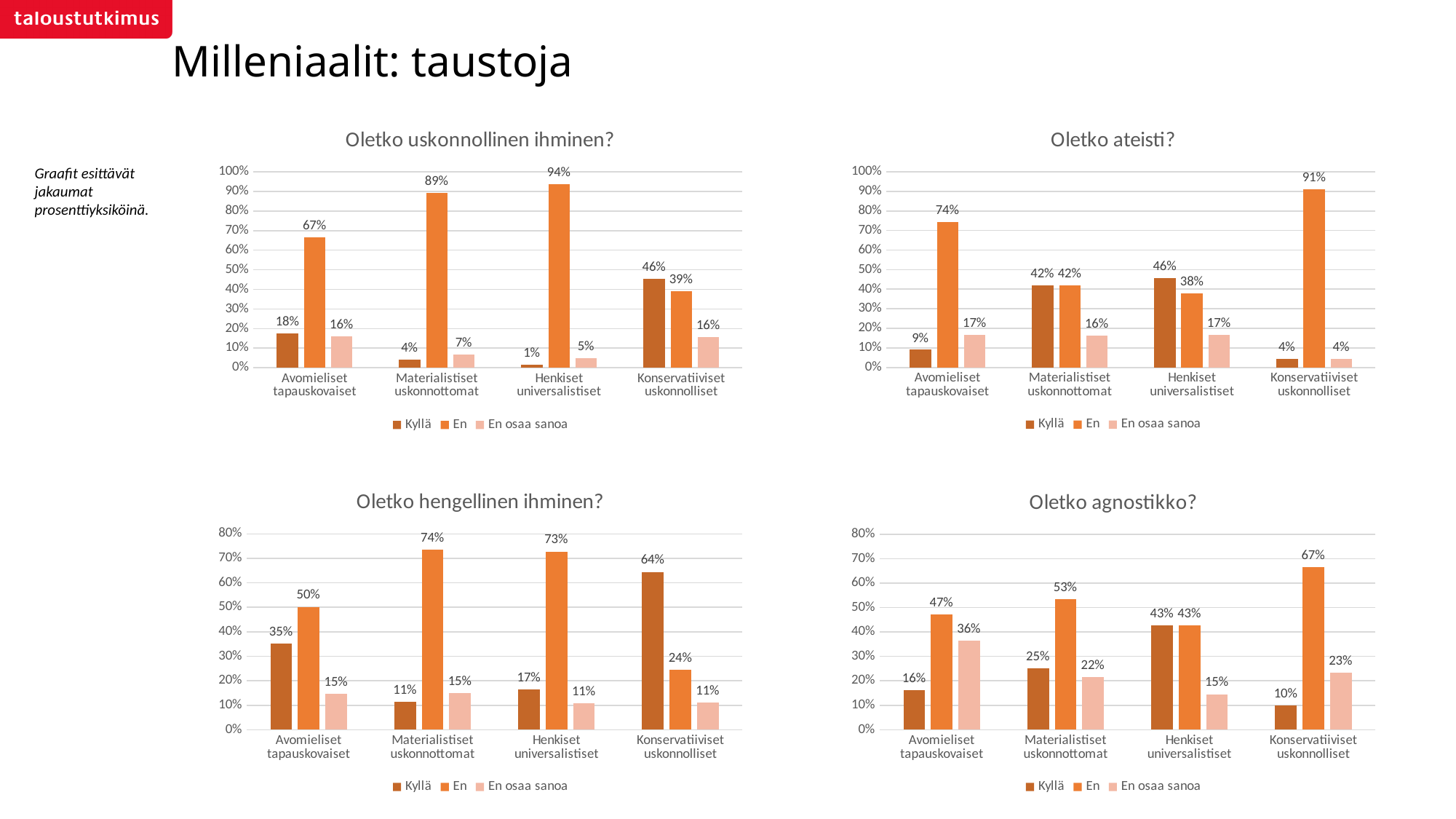
What kind of chart is the chart titled "Oletko hengellinen ihminen?"? bar chart In the chart titled "Oletko uskonnollinen ihminen?", which category has the highest "Kyllä" value? Konservatiiviset uskonnolliset How many series does the legend of the chart titled "Oletko agnostikko?" list? 3 In the chart titled "Oletko uskonnollinen ihminen?", what is the value of "En" for Henkiset universalistiset? 94% In the chart titled "Oletko ateisti?", which category has the lowest "En osaa sanoa" value? Konservatiiviset uskonnolliset In the chart titled "Oletko ateisti?", is the "En" value for Konservatiiviset uskonnolliset greater or less than 80%? greater In the chart titled "Oletko ateisti?", what is the "Kyllä" value for Henkiset universalistiset? 46% In the chart titled "Oletko agnostikko?", what is the "En osaa sanoa" value for Avomieliset tapauskovaiset? 36% In the chart titled "Oletko agnostikko?", what is the difference between the "En" and "Kyllä" values for Konservatiiviset uskonnolliset? 57% In the chart titled "Oletko uskonnollinen ihminen?", what is the difference between the "En" values for Materialistiset uskonnottomat and Avomieliset tapauskovaiset? 22% In the chart titled "Oletko hengellinen ihminen?", what is the "Kyllä" value for Konservatiiviset uskonnolliset? 64% In the chart titled "Oletko hengellinen ihminen?", which is larger: the "En" value for Materialistiset uskonnottomat or the "En" value for Avomieliset tapauskovaiset? Materialistiset uskonnottomat